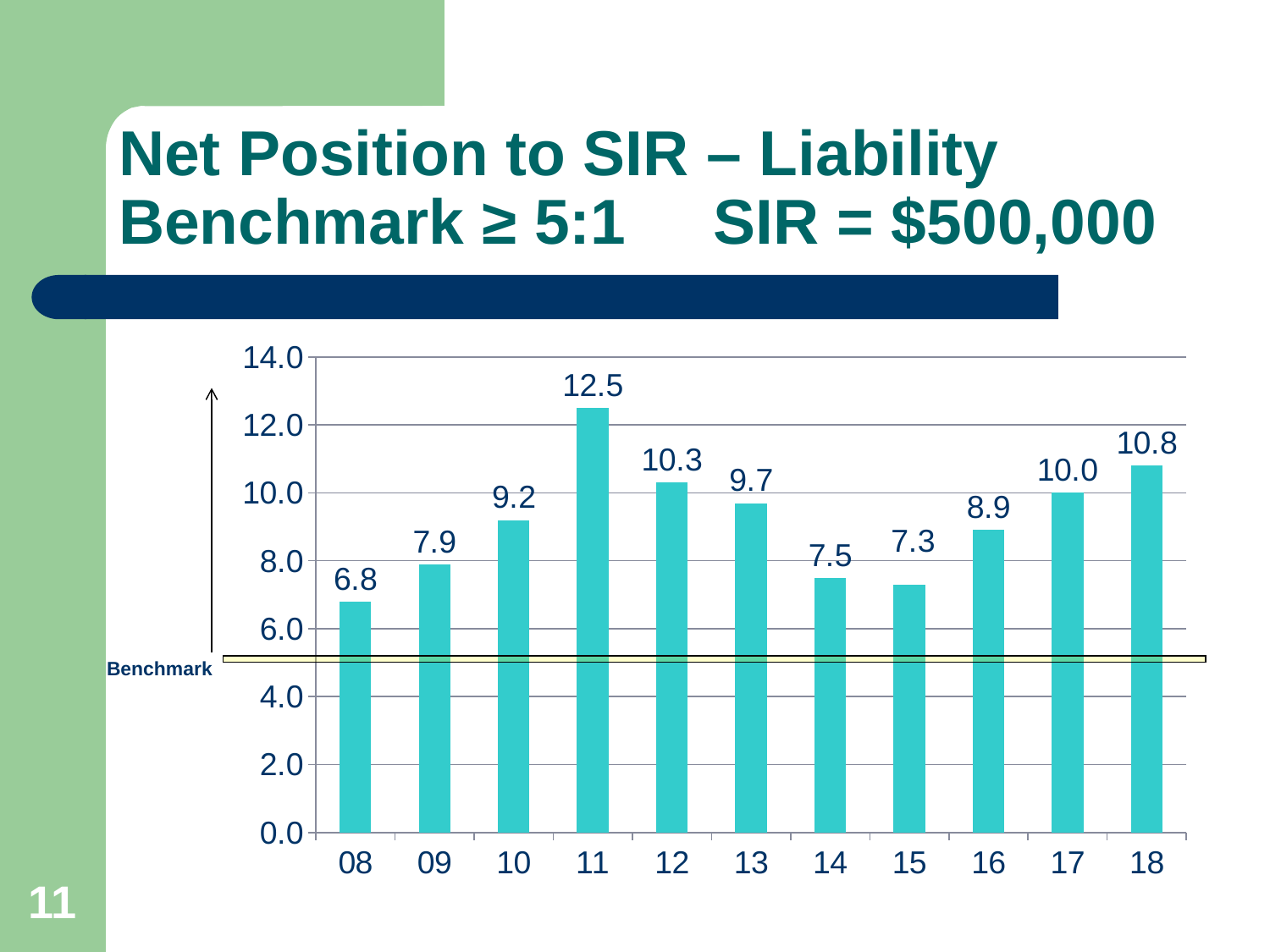
What kind of chart is shown on the slide? bar chart Which year has the highest value? 11 What is the value for 18? 10.8 How many years are shown on the x axis? 11 What is the difference between the values for 18 and 17? 0.8 What is the value for 15? 7.3 What is the value for 11? 12.5 Is the value for 14 greater or less than 8.0? less What is the difference between the values for 11 and 08? 5.7 Which is larger, the value for 12 or the value for 13? 12 Do the values rise or fall from 13 to 15? fall Which year has the lowest value? 08